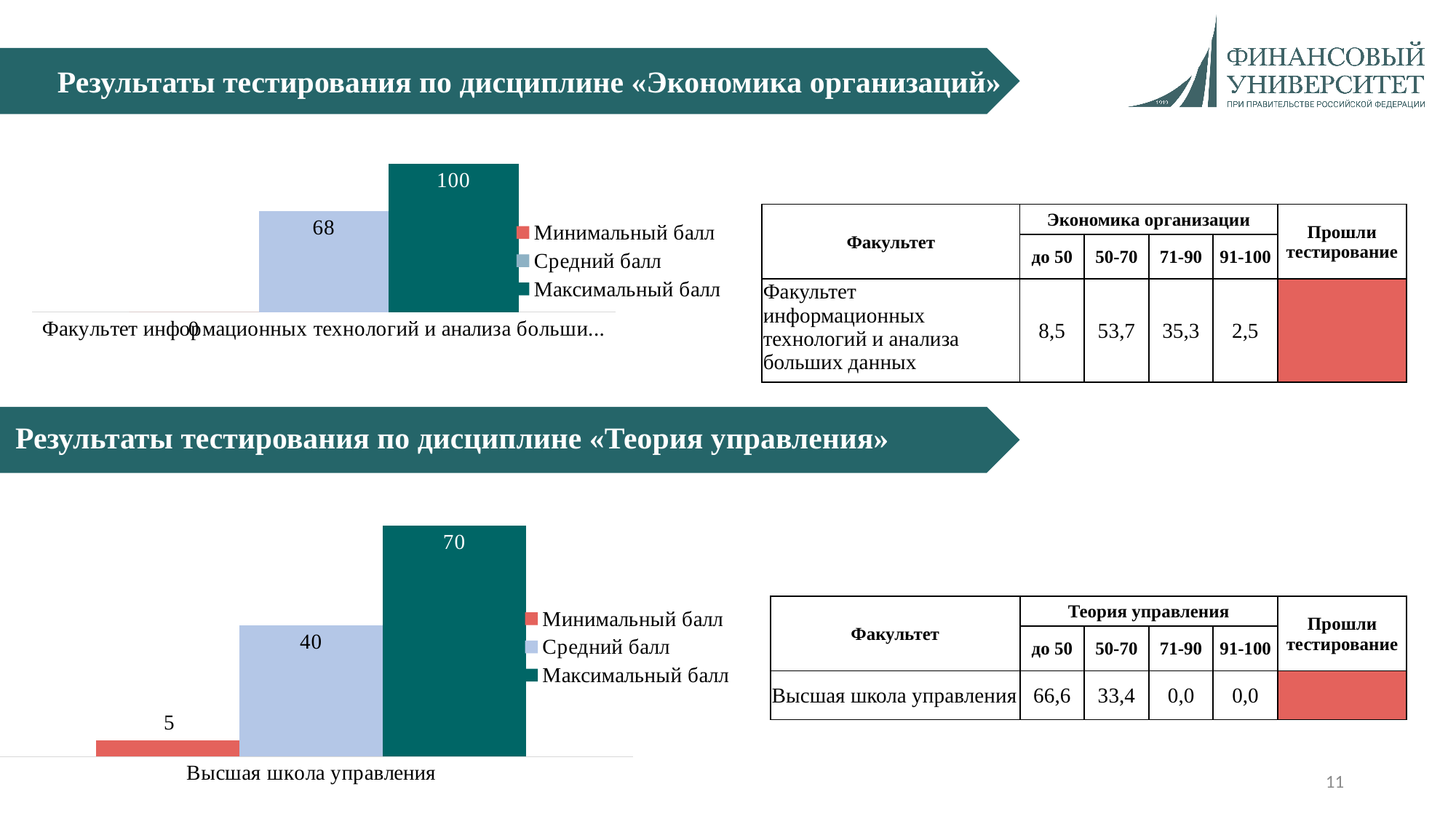
In the top chart, what is the value of Средний балл? 68 In the top chart, how many series does the legend list? 3 In the bottom chart, which colour represents Максимальный балл? Dark teal In the top chart, what is the value of Максимальный балл? 100 In the bottom chart, what is the value of Средний балл for Высшая школа управления? 40 What kind of chart is the bottom chart? Bar chart In the bottom chart, what is the value of Минимальный балл for Высшая школа управления? 5 In the bottom chart, which series has the lowest value? Минимальный балл In the bottom chart, what is the value of Максимальный балл for Высшая школа управления? 70 In the top chart, what is the difference between Максимальный балл and Средний балл? 32 In the top chart, what is the value of Минимальный балл? 0 In the bottom chart, what is the difference between Средний балл and Минимальный балл? 35